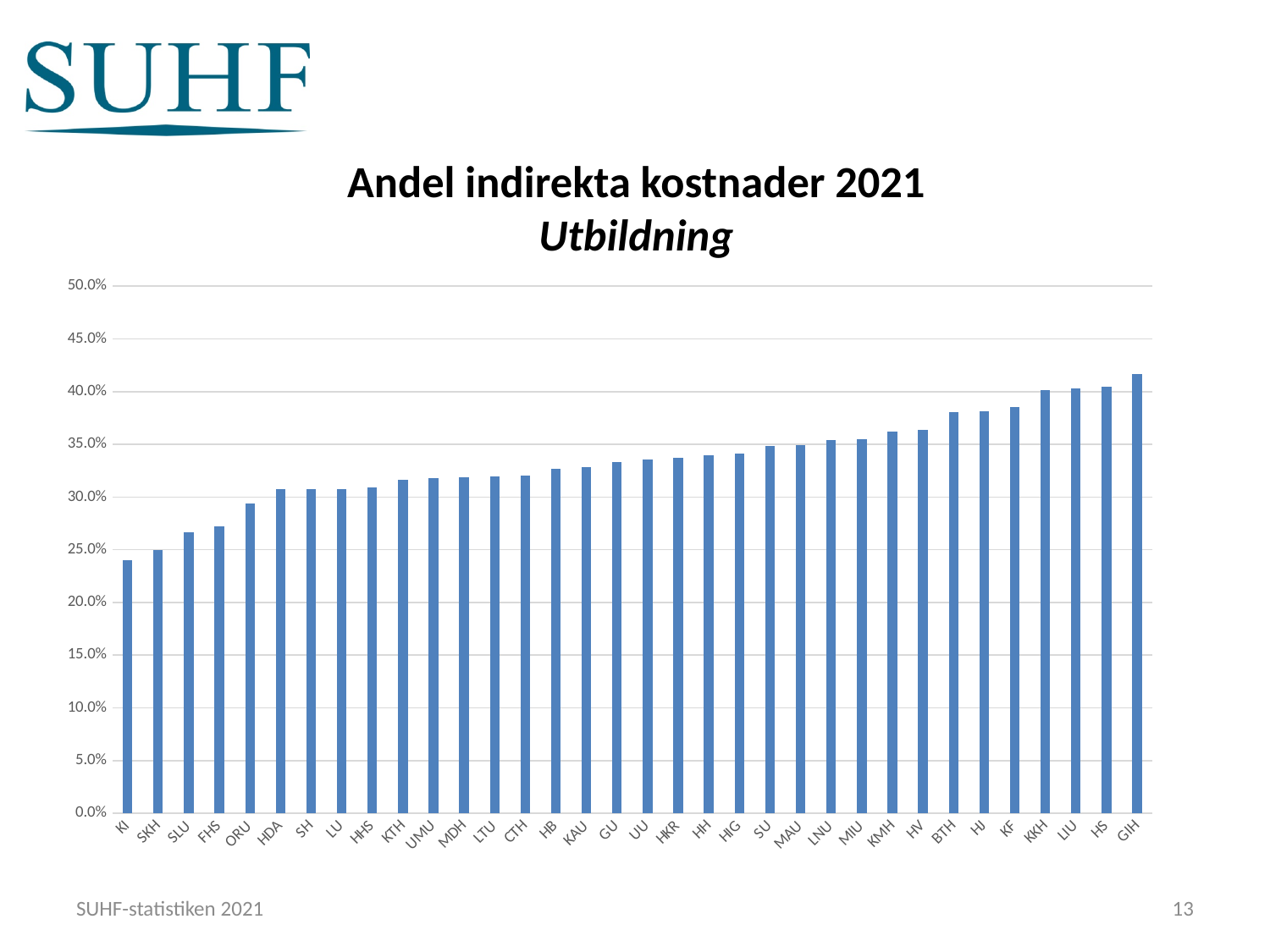
Which category has the highest value? GIH Is the value for KI greater or less than 25.0%? less Which has the larger value, SLU or BTH? BTH Which category has the lowest value? KI Which has the larger value, FHS or KF? KF What is the title of the chart? Andel indirekta kostnader 2021 Utbildning Do the values rise or fall from left to right along the x axis? rise Is the value for ORU greater or less than 30.0%? less Is the value for BTH greater or less than 35.0%? greater How many categories (institutions) are shown on the x axis? 34 What kind of chart is shown on the slide? bar chart